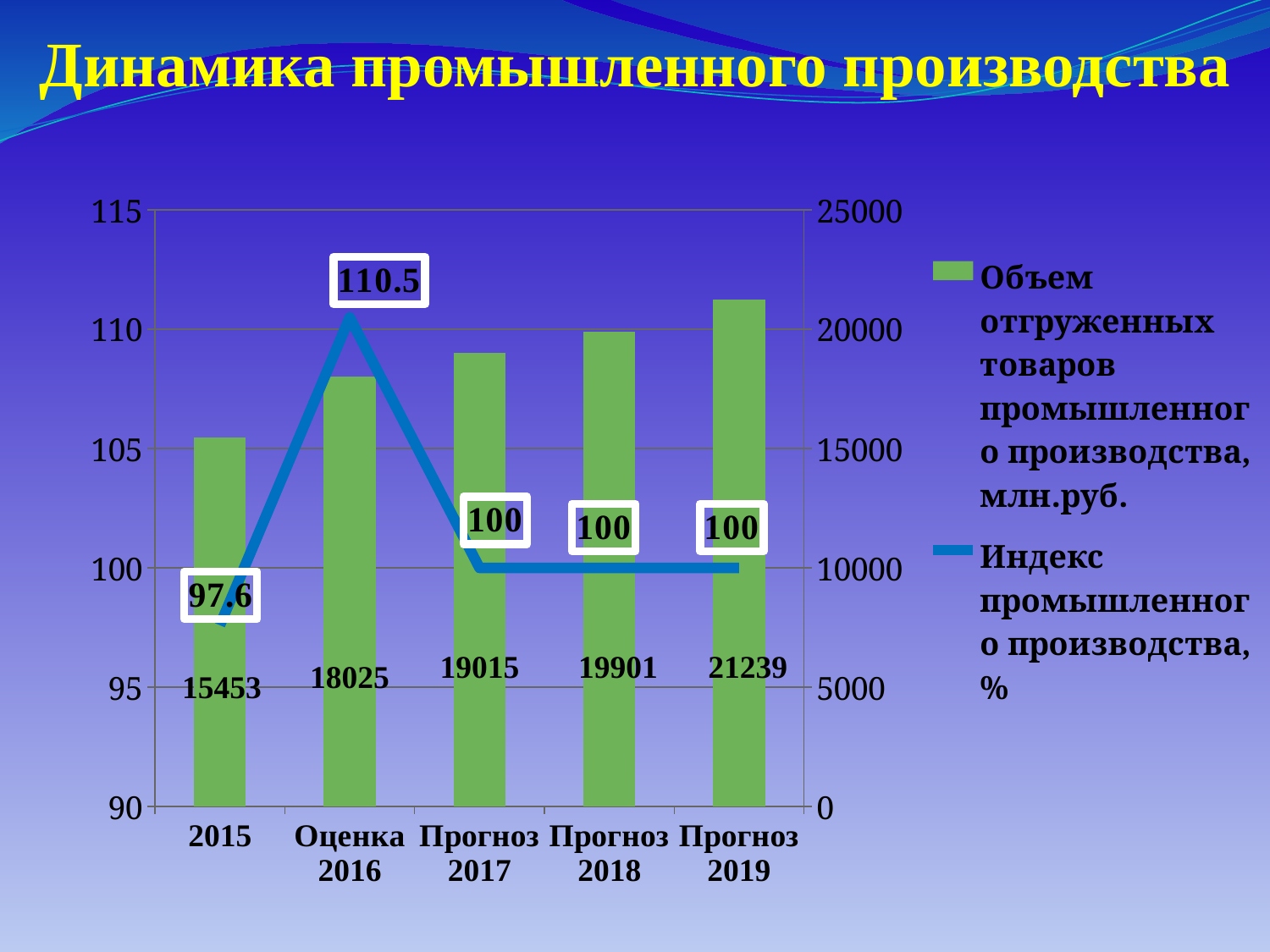
Which is larger, the volume of shipped goods for Прогноз 2017 or for Прогноз 2018? Прогноз 2018 How many categories are shown on the x axis? 5 What is the volume of shipped goods (Объем отгруженных товаров) for 2015? 15453 Which category has the highest volume of shipped goods? Прогноз 2019 What is the industrial production index (Индекс промышленного производства) for Оценка 2016? 110.5 What is the title of the slide? Динамика промышленного производства What is the difference in volume of shipped goods between Прогноз 2019 and 2015? 5786 Which category has the lowest industrial production index? 2015 How many series does the legend list? 2 What is the industrial production index for 2015? 97.6 Does the volume of shipped goods rise or fall from 2015 to Прогноз 2019? rise What is the volume of shipped goods for Прогноз 2019? 21239